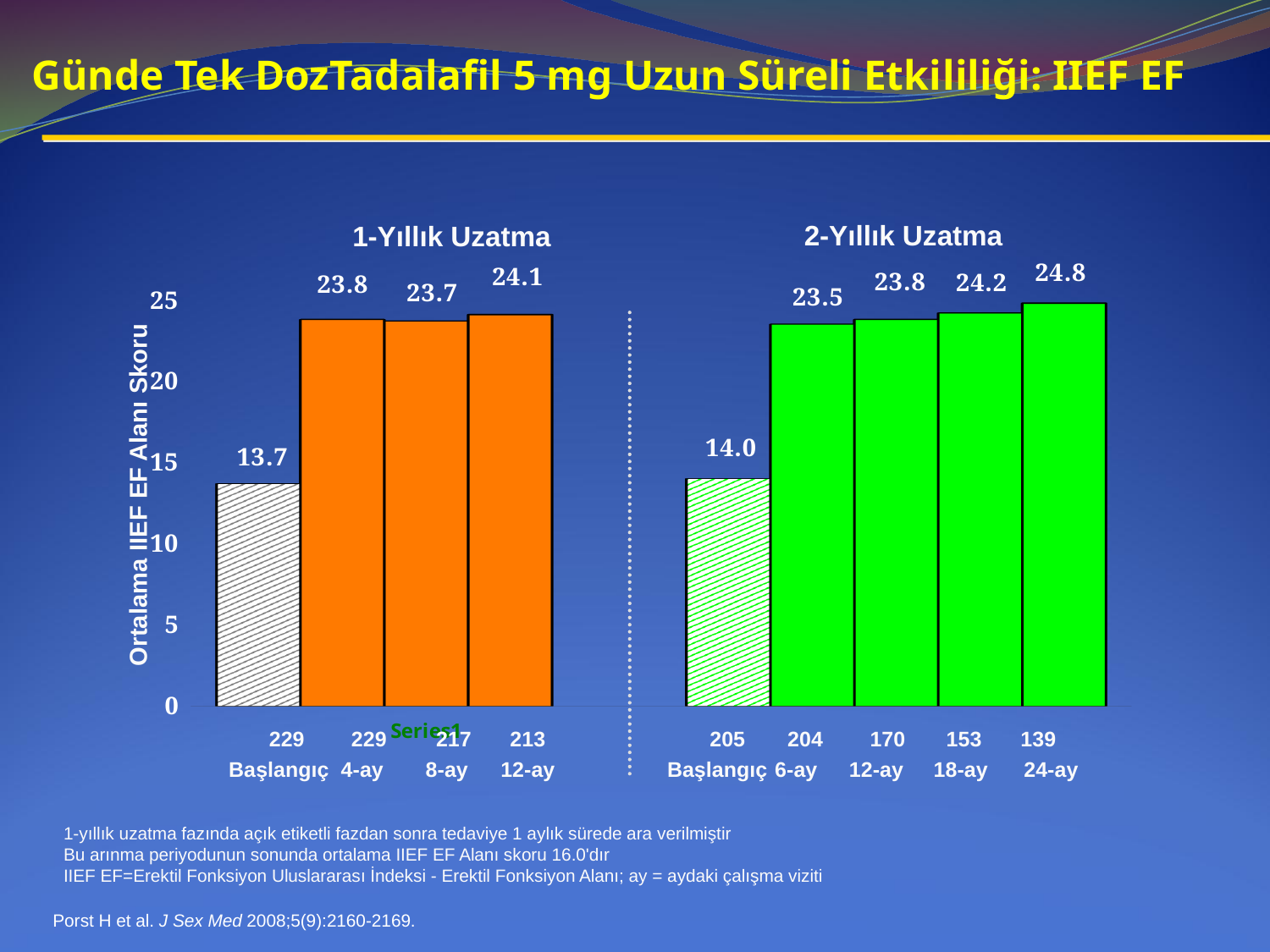
In the 1-Yıllık Uzatma chart, what is the difference between the 12-ay value and the Başlangıç value? 10.4 How many bars are in the 2-Yıllık Uzatma chart? 5 In the 2-Yıllık Uzatma chart, what is the difference between the 24-ay value and the Başlangıç value? 10.8 In the 2-Yıllık Uzatma chart, what is the value at 24-ay? 24.8 In the 1-Yıllık Uzatma chart, what is the value for Başlangıç? 13.7 What is the y-axis label of the charts? Ortalama IIEF EF Alanı Skoru In the 1-Yıllık Uzatma chart, which category has the lowest value? Başlangıç What type of chart is used on this slide? Bar chart In the 2-Yıllık Uzatma chart, which category has the highest value? 24-ay In the 1-Yıllık Uzatma chart, what is the value at 12-ay? 24.1 Which is larger: the Başlangıç value in the 1-Yıllık Uzatma chart or the Başlangıç value in the 2-Yıllık Uzatma chart? 2-Yıllık Uzatma (14.0) In the 2-Yıllık Uzatma chart, what is the value at 6-ay? 23.5